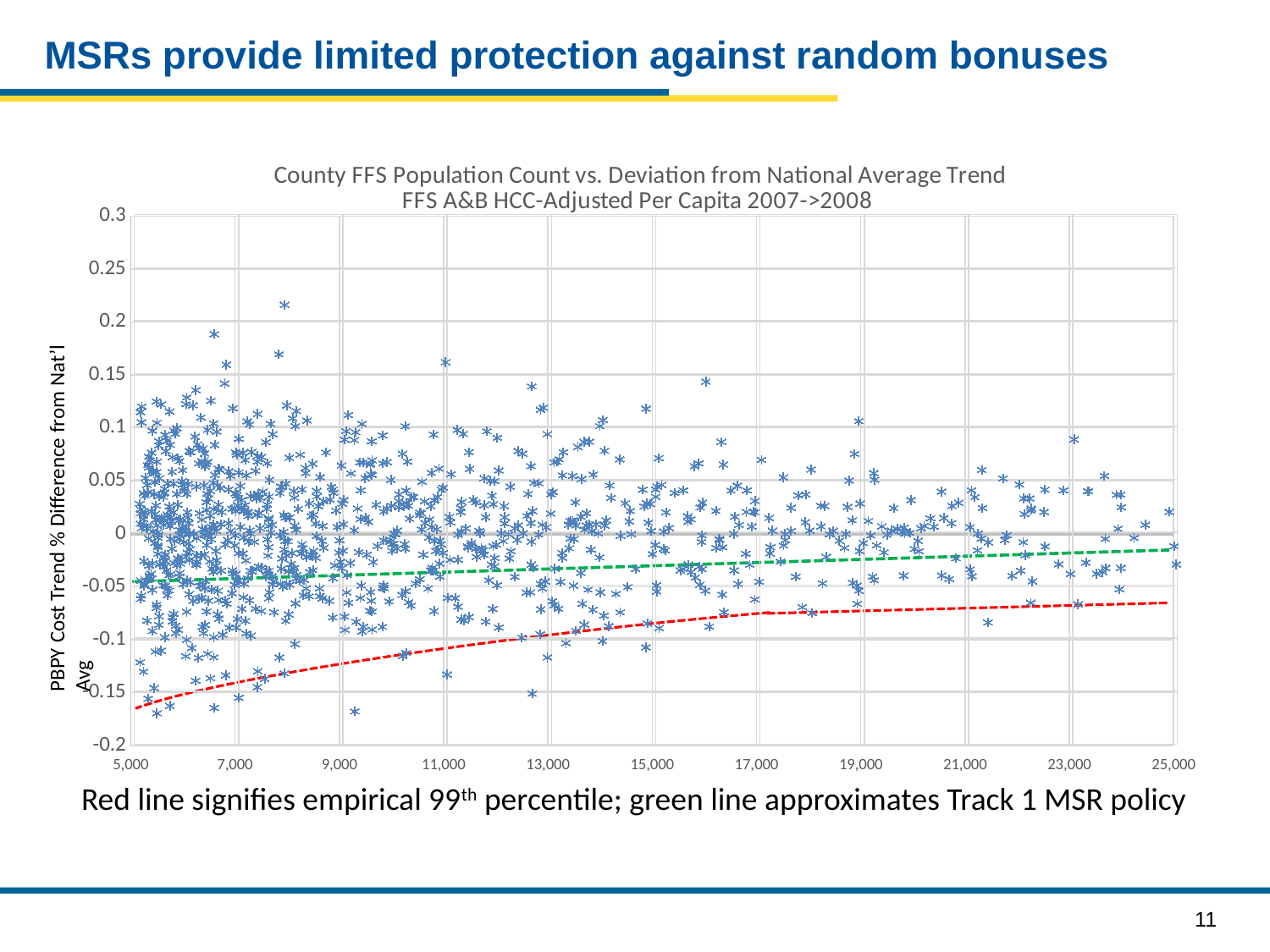
Is the highest plotted point on the chart greater or less than 0.2? greater What is the title of the chart? County FFS Population Count vs. Deviation from National Average Trend FFS A&B HCC-Adjusted Per Capita 2007->2008 Does the red dashed line rise or fall as the population count increases along the x axis? Rises According to the caption, what does the red dashed line signify? Empirical 99th percentile At a population count of 25,000, is the green dashed line greater or less than -0.05? greater What kind of chart is shown on the slide? Scatter chart Is the lowest plotted point on the chart greater or less than -0.15? less Does the green dashed line rise or fall as the population count increases along the x axis? Rises At a population count of 25,000, which line is higher, the green dashed line or the red dashed line? Green dashed line